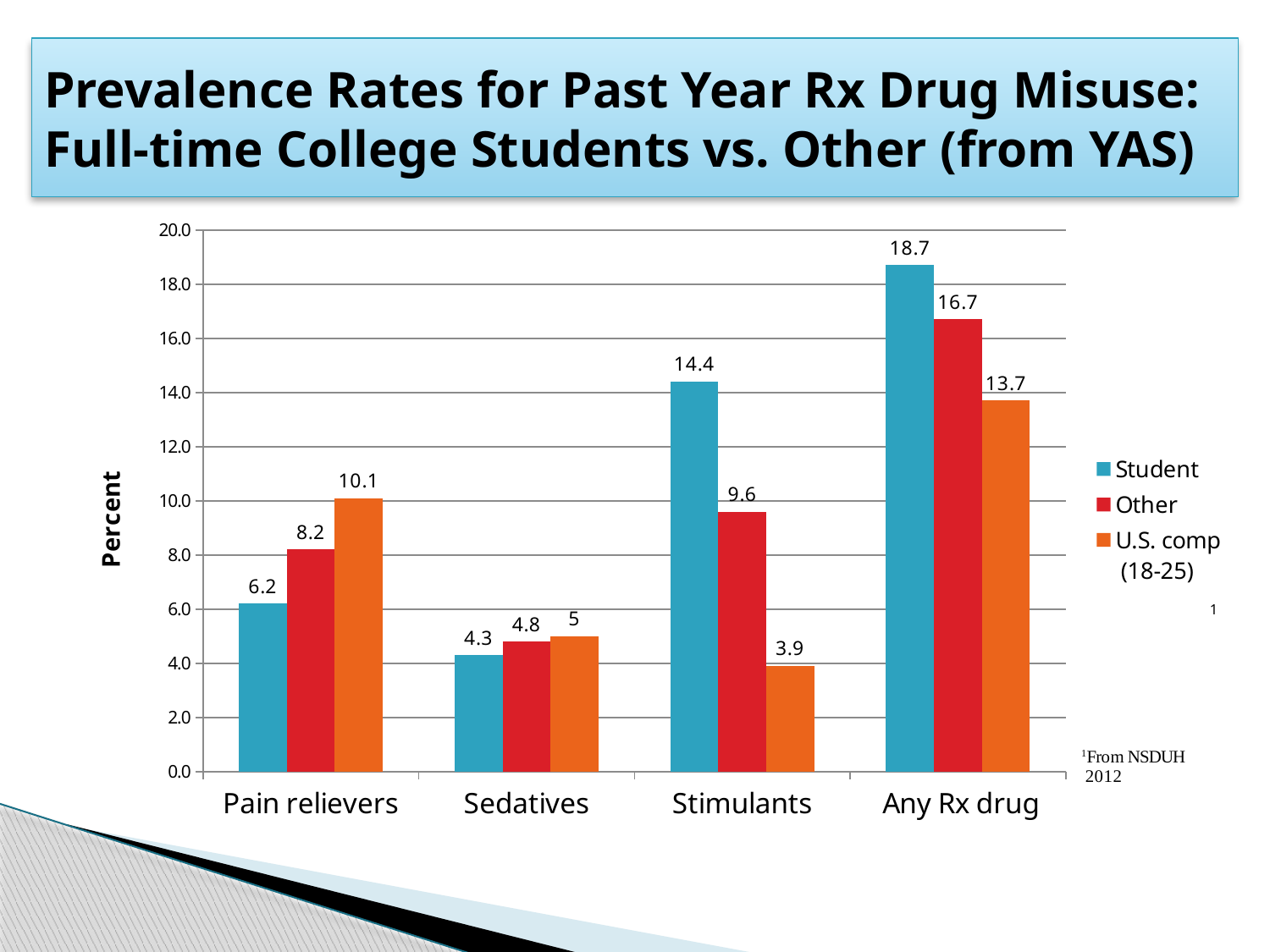
What is the label of the y axis? Percent How many series does the legend list? 3 What kind of chart is shown on the slide? bar chart Which category has the lowest U.S. comp (18-25) value? Stimulants How many categories are shown on the x axis? 4 What is the Student value for Stimulants? 14.4 What is the U.S. comp (18-25) value for Pain relievers? 10.1 What is the Other value for Sedatives? 4.8 Which is larger for Pain relievers, the Student value or the Other value? Other Which category has the highest Student value? Any Rx drug Is the Other value for Stimulants greater or less than 8.0? greater What is the difference between the Student and Other values for Any Rx drug? 2.0